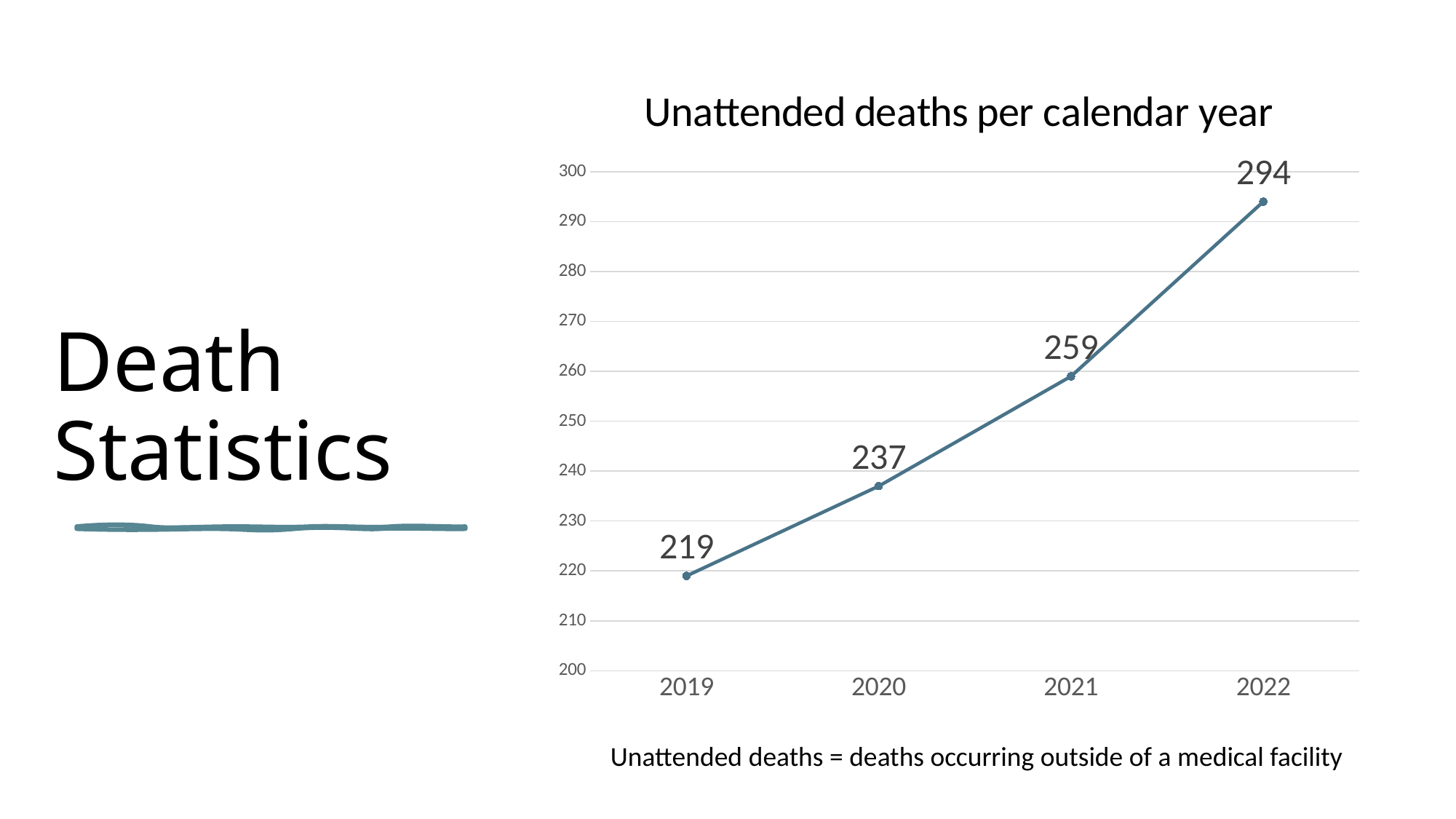
How many years are plotted on the chart? 4 What is the value for 2022? 294 What is the difference between the values for 2020 and 2019? 18 Which year has the lowest number of unattended deaths? 2019 Which is larger, the value for 2021 or the value for 2020? 2021 Do the values rise or fall from 2019 to 2022? Rise What kind of chart is shown on the slide? Line chart What is the value for 2019? 219 Which year has the highest number of unattended deaths? 2022 What is the value for 2020? 237 What is the difference between the values for 2022 and 2021? 35 What is the value for 2021? 259